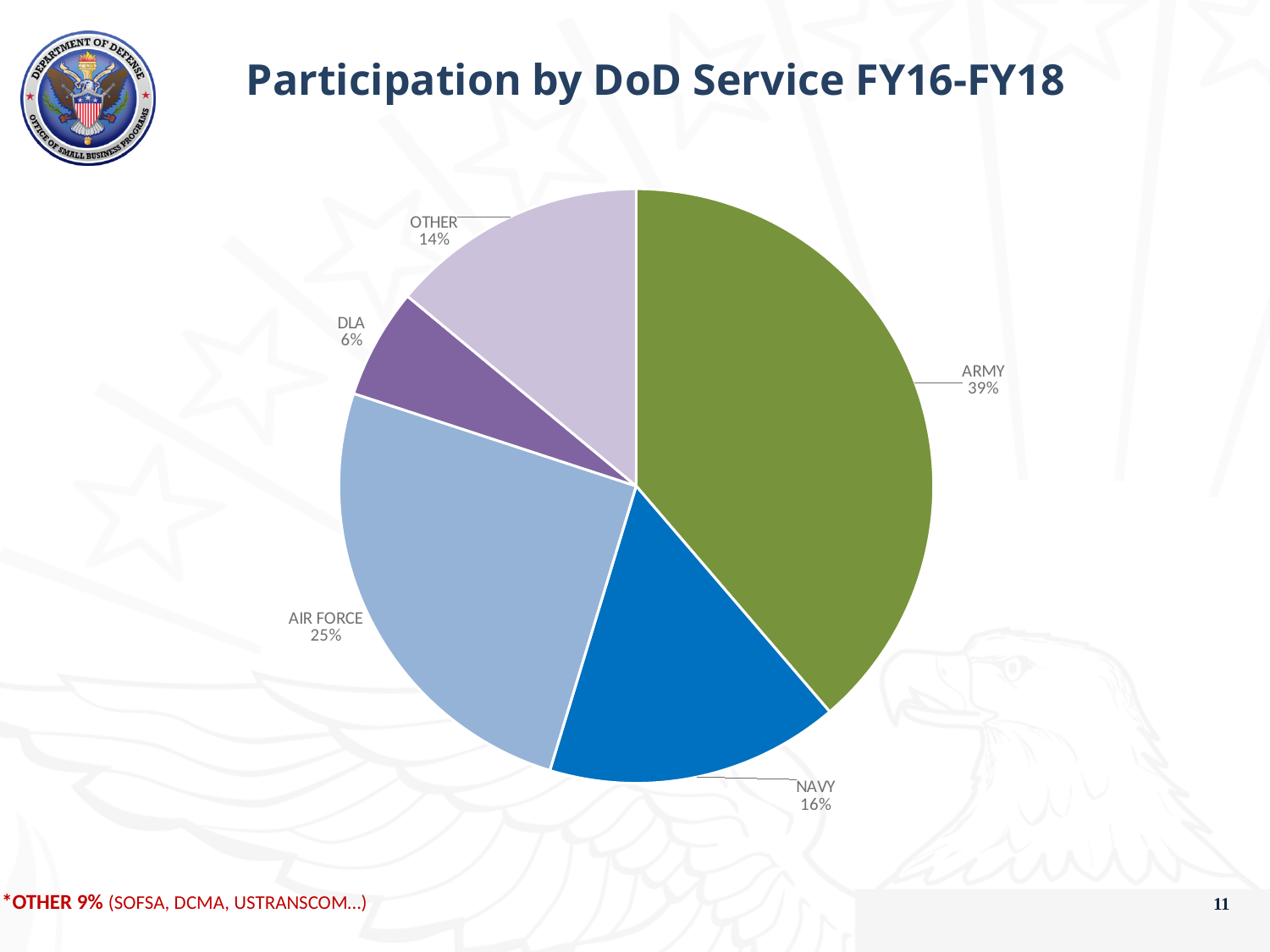
How many slices does the pie chart have? 5 Which service has the largest share of participation? ARMY What share of participation does ARMY have? 39% What is the title of the chart? Participation by DoD Service FY16-FY18 What is the difference in percentage points between ARMY and AIR FORCE? 14 What share of participation does DLA have? 6% What type of chart is shown on the slide? pie chart Which has a larger share, NAVY or OTHER? NAVY What share of participation does AIR FORCE have? 25% Which category has the smallest share of participation? DLA What share of participation does OTHER have? 14% What share of participation does NAVY have? 16%